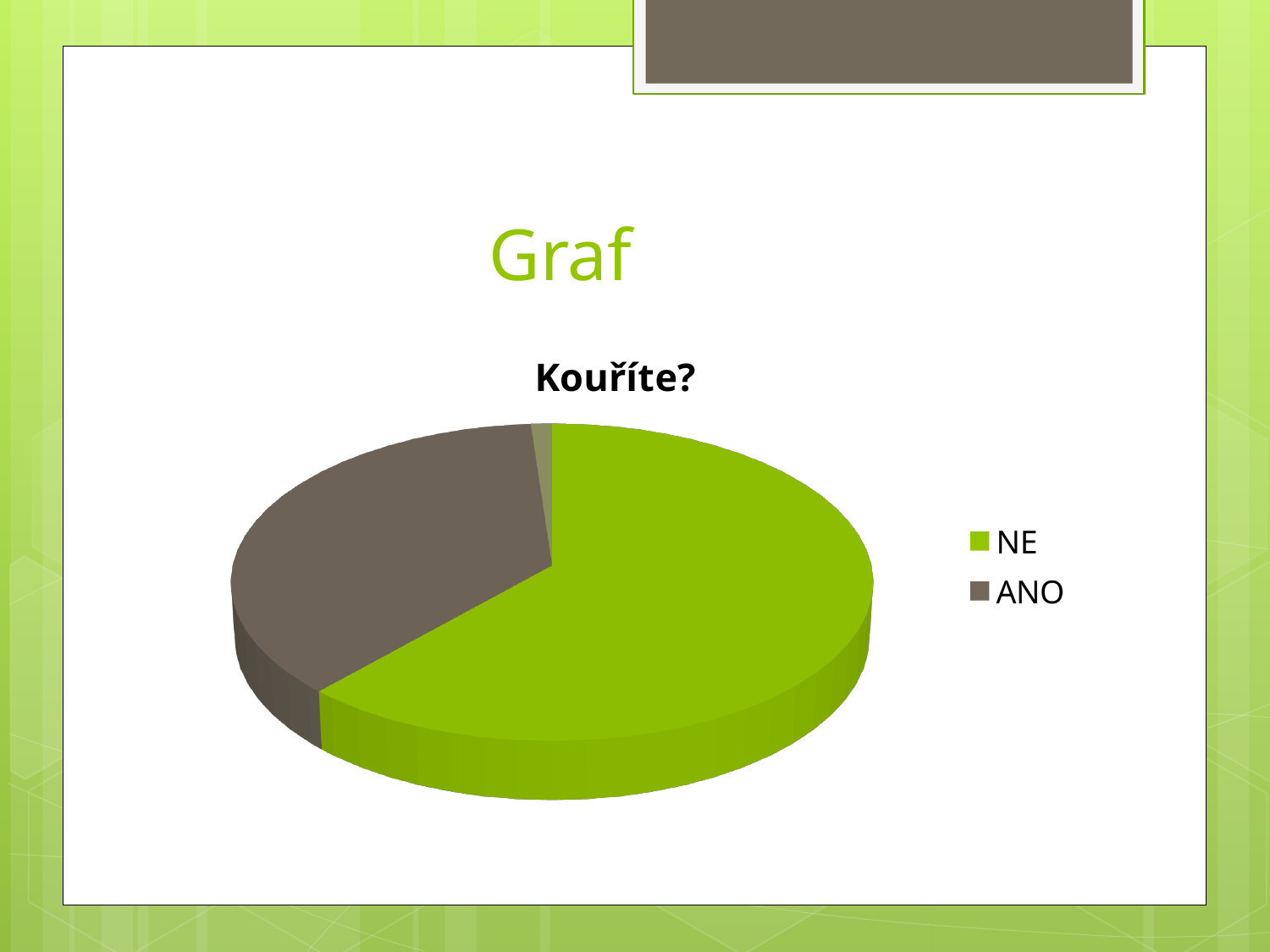
Does the NE slice take up more or less than half of the pie? more Which category has the smaller slice, NE or ANO? ANO How many entries does the legend list? 2 What kind of chart is shown on the slide? pie chart What is the title of the chart? Kouříte? What colour is the NE slice in the pie chart? green Which slice is larger, NE or ANO? NE Which category has the largest slice of the pie? NE